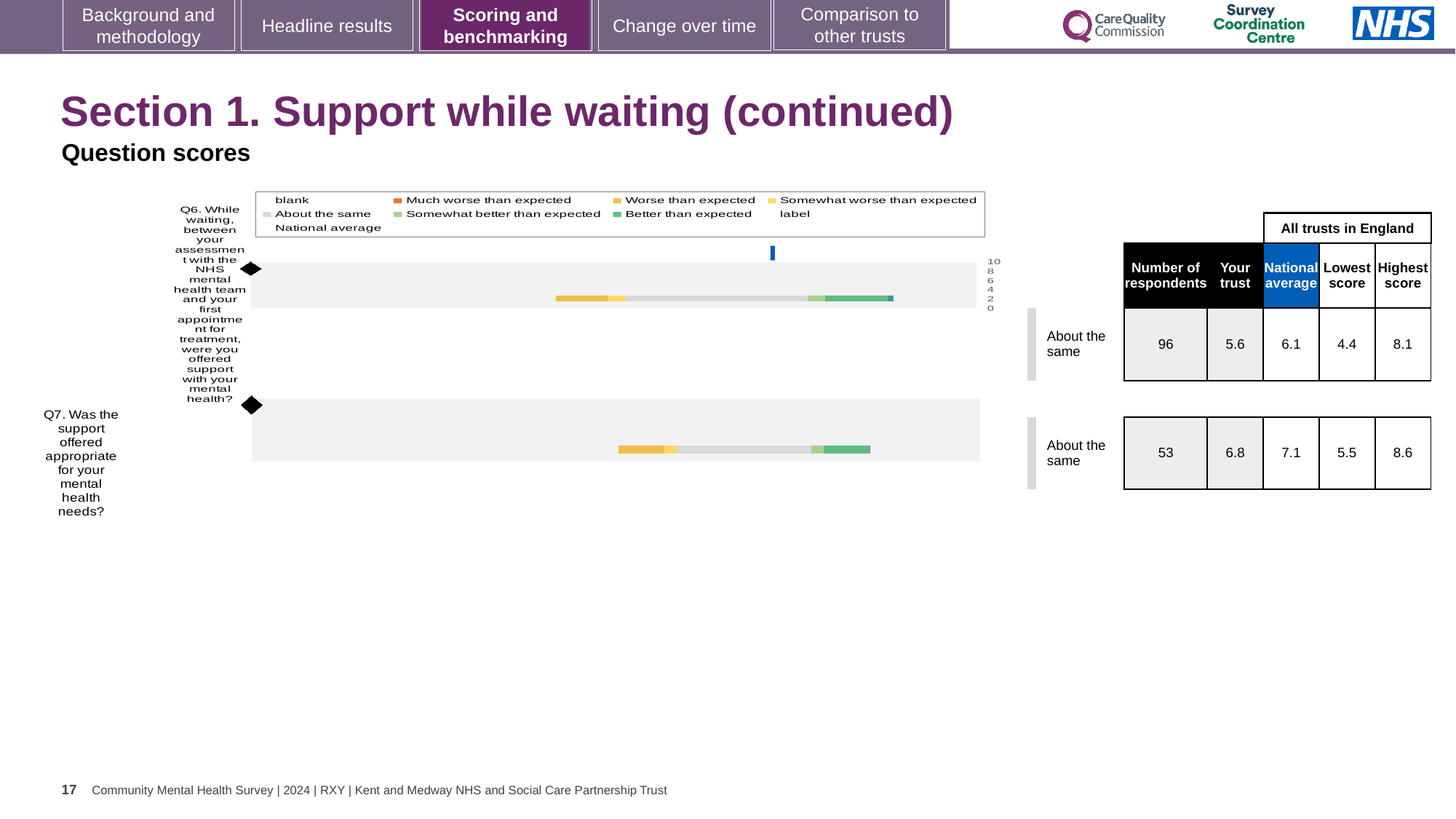
In the table beside the chart, what is the highest score among all trusts in England for Q7? 8.6 Which legend entry is shown in dark green? Better than expected In the table beside the chart, what is the 'Your trust' score for Q6? 5.6 In the table beside the chart, how many respondents answered Q6? 96 What benchmark category is shown for Q7 next to the chart? About the same In the table beside the chart, what is the lowest score among all trusts in England for Q6? 4.4 Which question has the higher 'Your trust' score in the table beside the chart, Q6 or Q7? Q7 In the table beside the chart, what is the national average for Q7? 7.1 What kind of chart is shown on the slide? bar chart What is the difference between the highest and lowest scores for Q6 in the table beside the chart? 3.7 How many questions (bars) are plotted in the chart? 2 What is the highest value shown on the chart's axis? 10